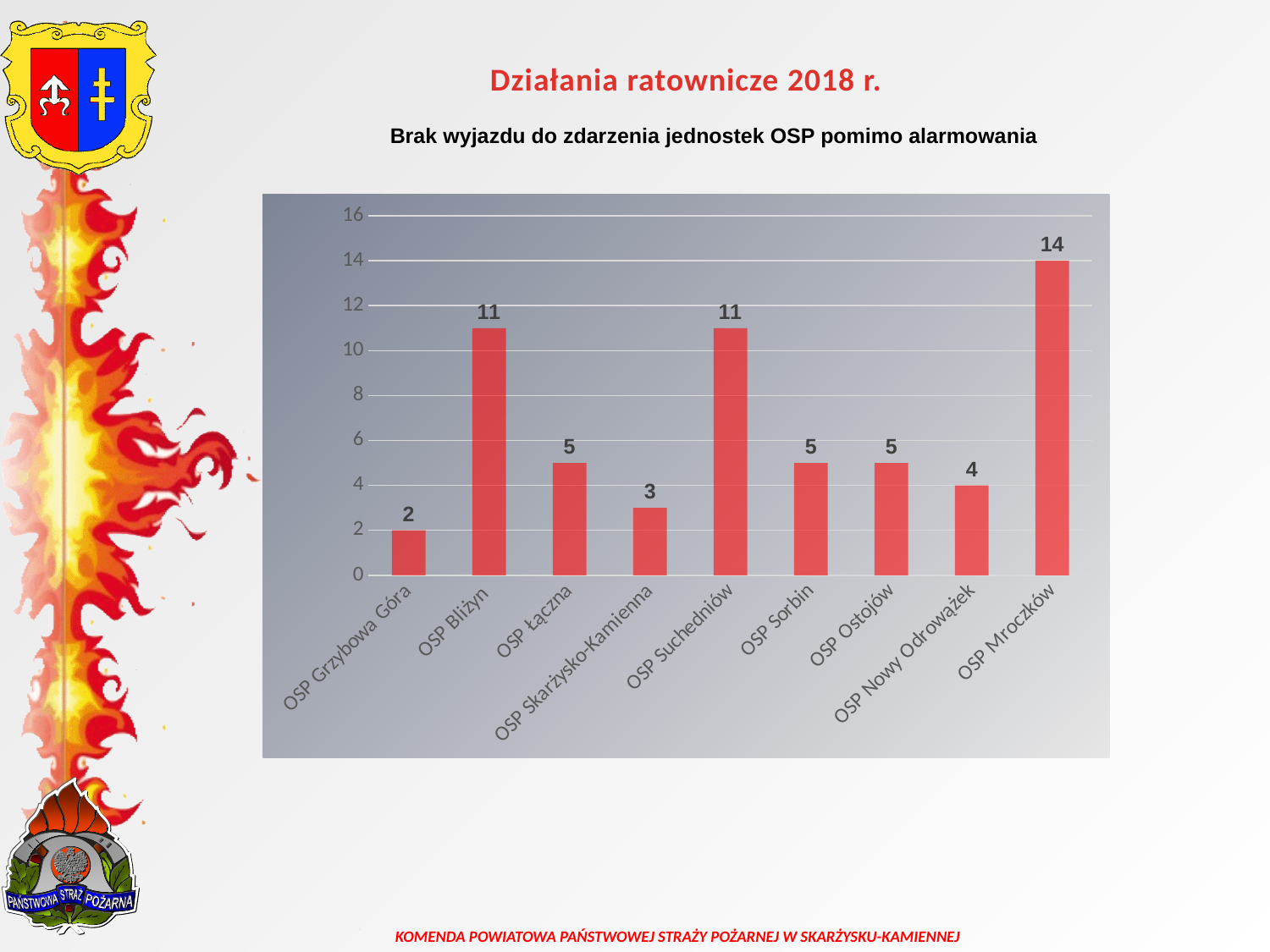
What is the subtitle printed above the chart? Brak wyjazdu do zdarzenia jednostek OSP pomimo alarmowania What is the value for OSP Grzybowa Góra? 2 Which category has the highest value? OSP Mroczków Which category has the lowest value? OSP Grzybowa Góra What is the difference between the values for OSP Mroczków and OSP Bliżyn? 3 What is the value for OSP Mroczków? 14 What kind of chart is shown on the slide? bar chart Which is larger, the value for OSP Łączna or the value for OSP Skarżysko-Kamienna? OSP Łączna What is the difference between the values for OSP Suchedniów and OSP Sorbin? 6 What is the value for OSP Nowy Odrowążek? 4 What is the value for OSP Skarżysko-Kamienna? 3 How many categories are shown on the x axis? 9